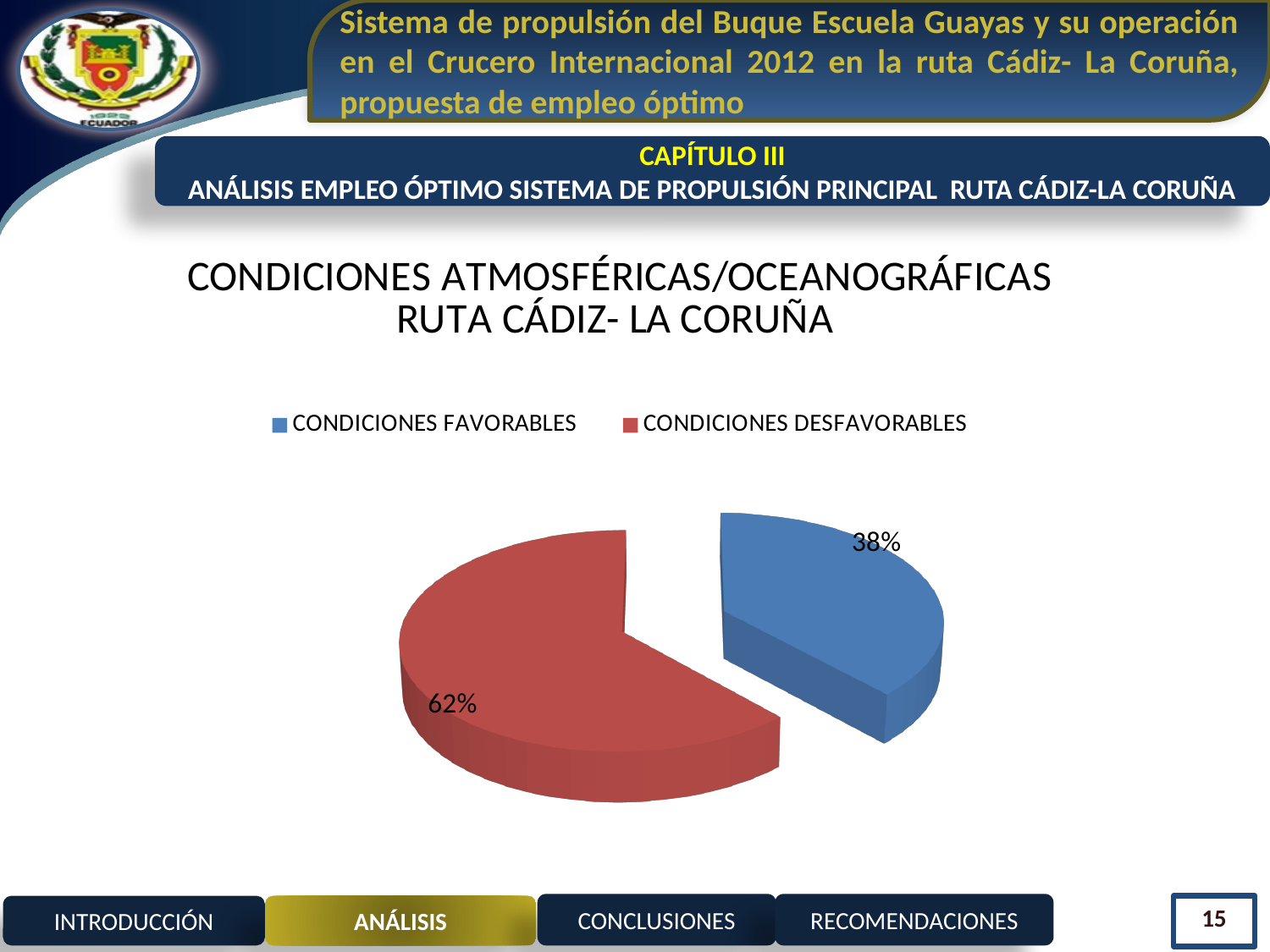
What is the difference in percentage points between CONDICIONES DESFAVORABLES and CONDICIONES FAVORABLES? 24 Which category has the smallest slice of the pie? CONDICIONES FAVORABLES What colour is the slice for CONDICIONES DESFAVORABLES? Red What colour is the slice for CONDICIONES FAVORABLES? Blue What share of the pie is labelled CONDICIONES DESFAVORABLES? 62% What share of the pie is labelled CONDICIONES FAVORABLES? 38% Which category has the largest slice of the pie? CONDICIONES DESFAVORABLES Which is larger, the slice for CONDICIONES FAVORABLES or the slice for CONDICIONES DESFAVORABLES? CONDICIONES DESFAVORABLES How many entries does the legend list? 2 How many slices does the pie chart have? 2 Is the share for CONDICIONES DESFAVORABLES greater or less than 50%? greater What kind of chart is shown on the slide? Pie chart